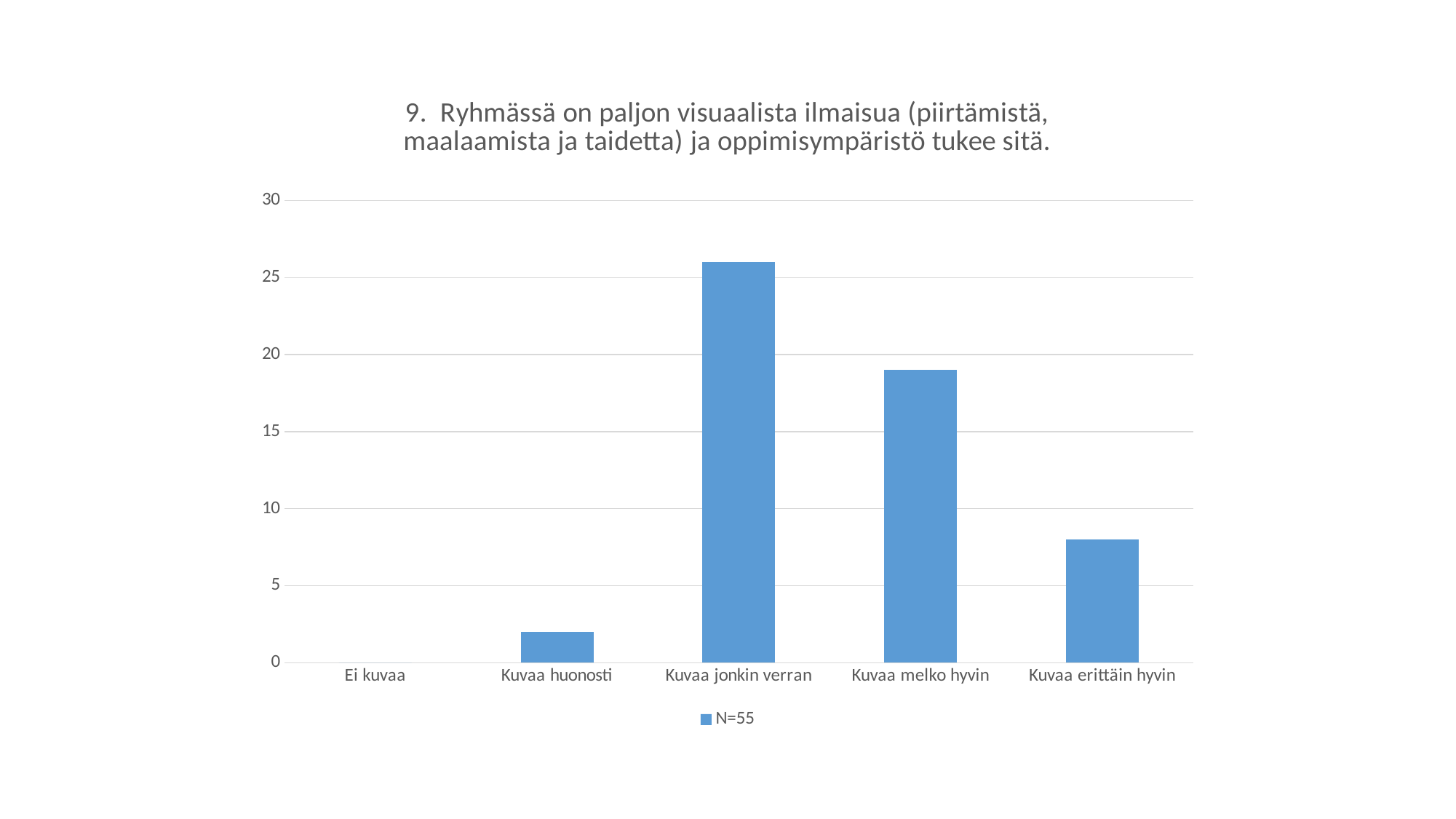
Is the value for Kuvaa melko hyvin greater or less than 20? less Is the value for Kuvaa jonkin verran greater or less than 25? greater How many categories are shown on the x axis of the chart? 5 Which category has the highest bar in the chart? Kuvaa jonkin verran How many series does the legend list? 1 What is the legend entry for the series in the chart? N=55 Is the value for Kuvaa huonosti greater or less than 5? less Which category has the lowest value in the chart? Ei kuvaa Which is larger, the value for Kuvaa melko hyvin or the value for Kuvaa erittäin hyvin? Kuvaa melko hyvin What is the value for Ei kuvaa? 0 What kind of chart is shown on the slide? bar chart